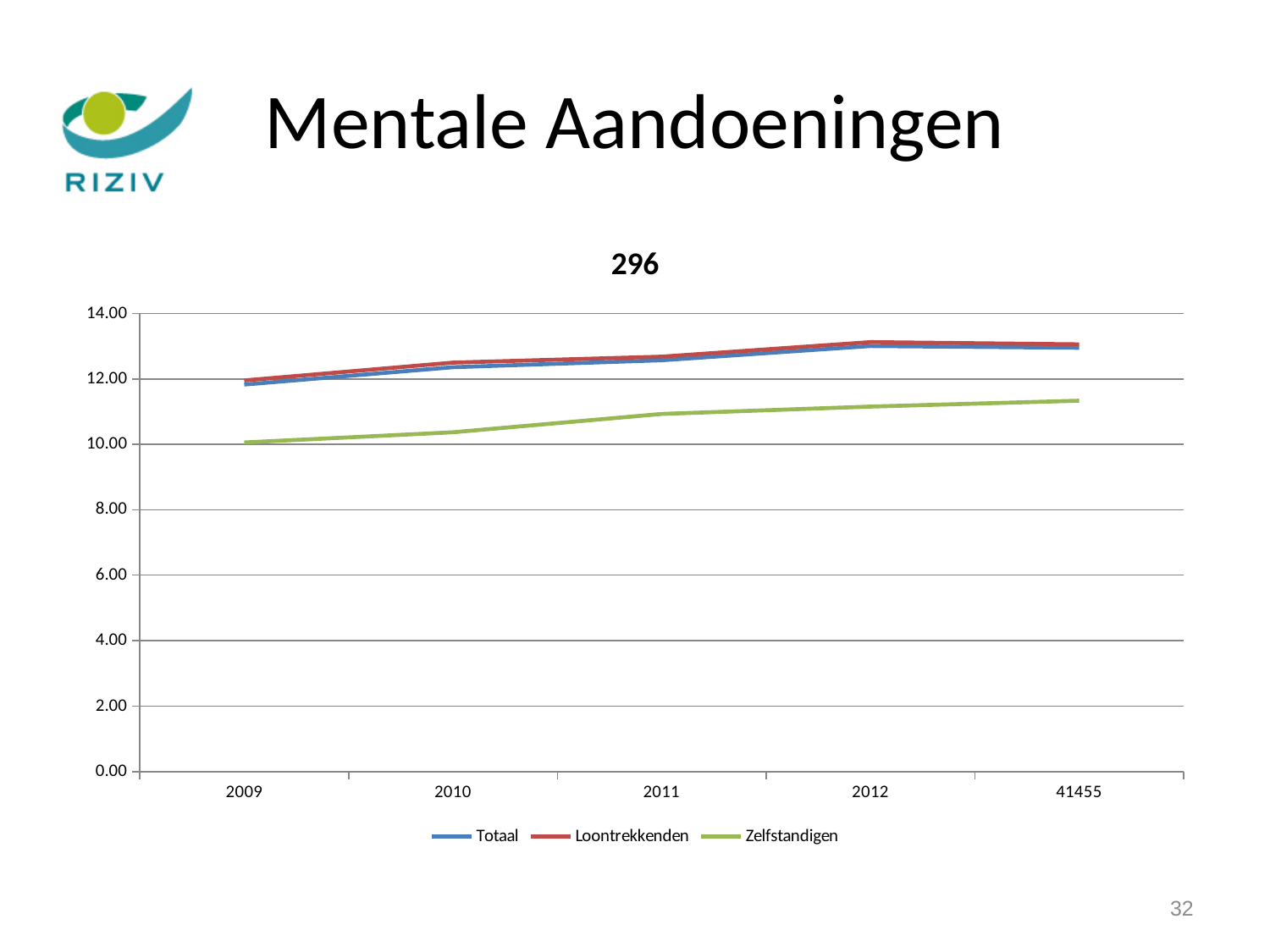
Which series has the lowest values across all years? Zelfstandigen In 2011, which is larger: Loontrekkenden or Zelfstandigen? Loontrekkenden Is the value for Loontrekkenden in 2012 greater or less than 12.00? greater Which series is drawn in green? Zelfstandigen Does the Zelfstandigen line rise or fall from 2009 to the last point? rise What kind of chart is shown on the slide? line chart Does the Loontrekkenden line rise or fall from 2009 to 2012? rise Is the value for Zelfstandigen in 2011 greater or less than 10.00? greater Is the value for Zelfstandigen in 2012 greater or less than 12.00? less What is the title of the chart? 296 How many points are plotted along the x axis for each series? 5 How many series does the legend list? 3